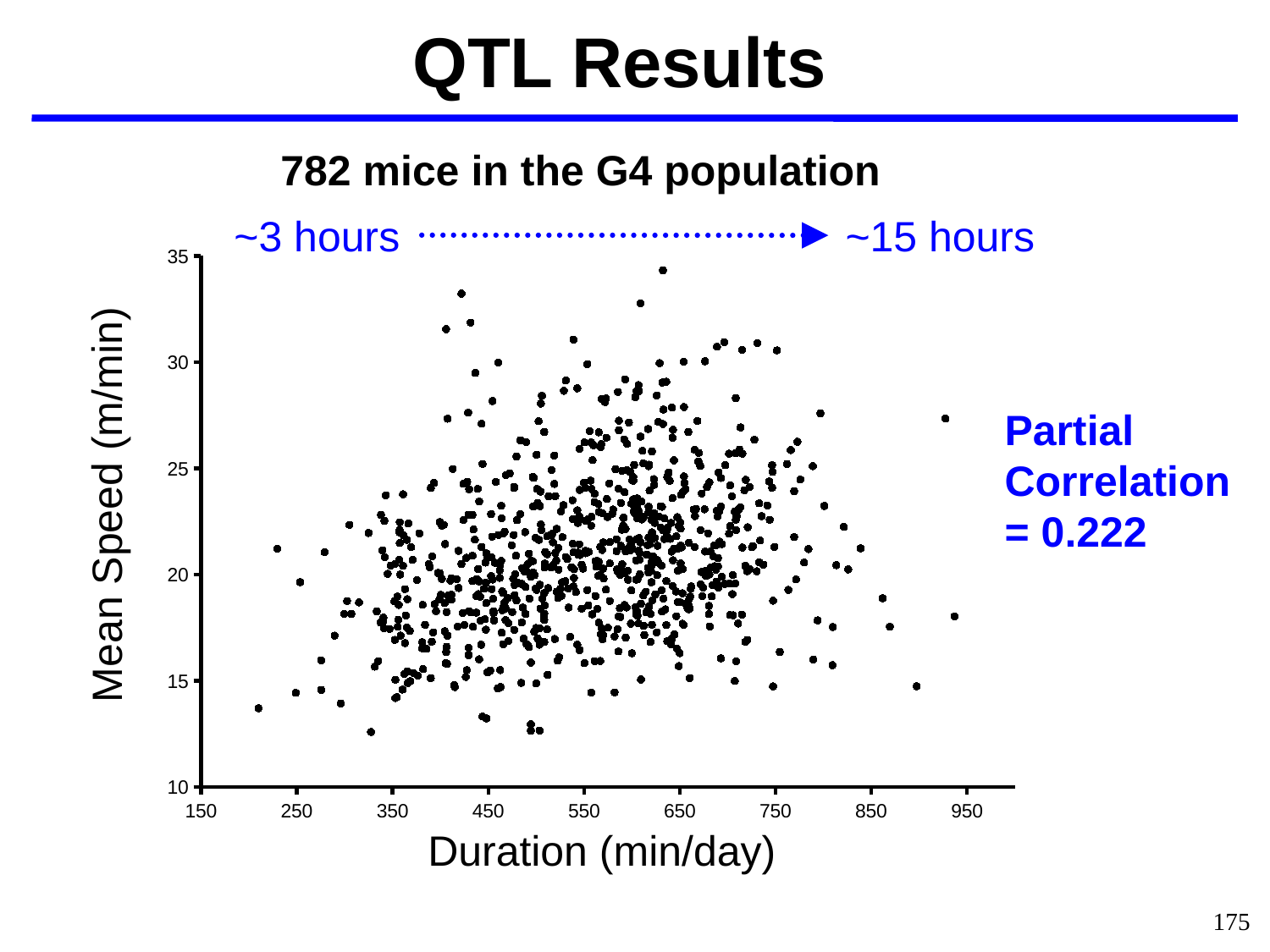
What is the lowest tick value shown on the y axis? 10 Do the mean speed values tend to rise or fall as duration increases along the x axis? rise What is the label of the x axis of the chart? Duration (min/day) What kind of chart is shown on the slide? scatter plot What is the label of the y axis of the chart? Mean Speed (m/min) Is the duration of the leftmost point in the chart greater or less than 250 min/day? less Which population of mice does the chart describe? G4 population What is the partial correlation value stated next to the chart? 0.222 Is the mean speed of the highest point in the chart greater or less than 30 m/min? greater How many mice are plotted in the chart, according to the slide? 782 What is the highest tick value shown on the x axis? 950